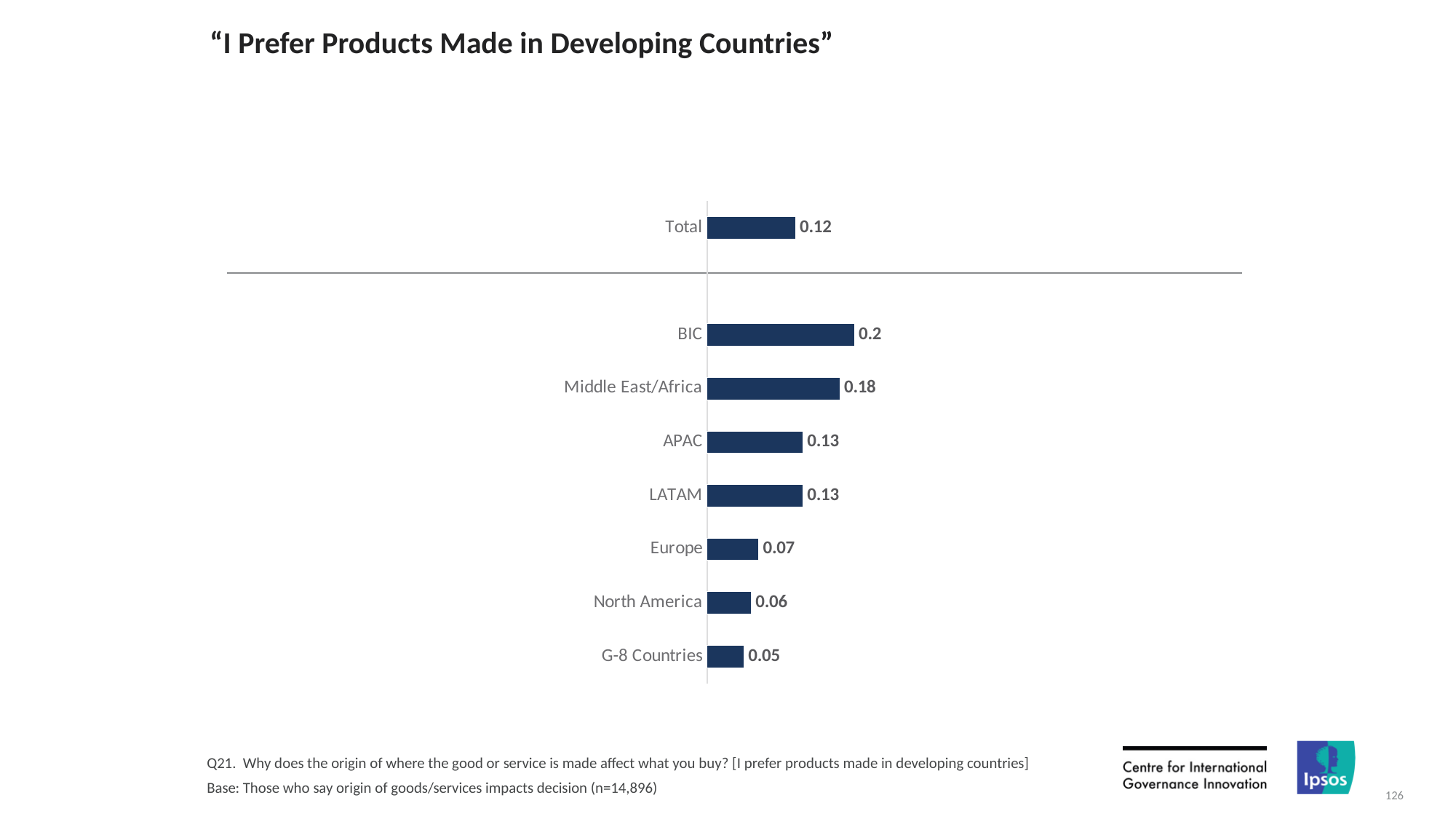
Which is larger, the value for Middle East/Africa or the value for APAC? Middle East/Africa Which region has the highest value? BIC What is the value for North America? 0.06 What is the title of the chart? "I Prefer Products Made in Developing Countries" What is the difference between the values for BIC and Europe? 0.13 How many bars are plotted on the chart? 8 What is the value for Middle East/Africa? 0.18 What is the value for Total? 0.12 What is the difference between the values for Total and G-8 Countries? 0.07 What is the value for BIC? 0.2 Which category has the lowest value? G-8 Countries What kind of chart is shown on the slide? Bar chart